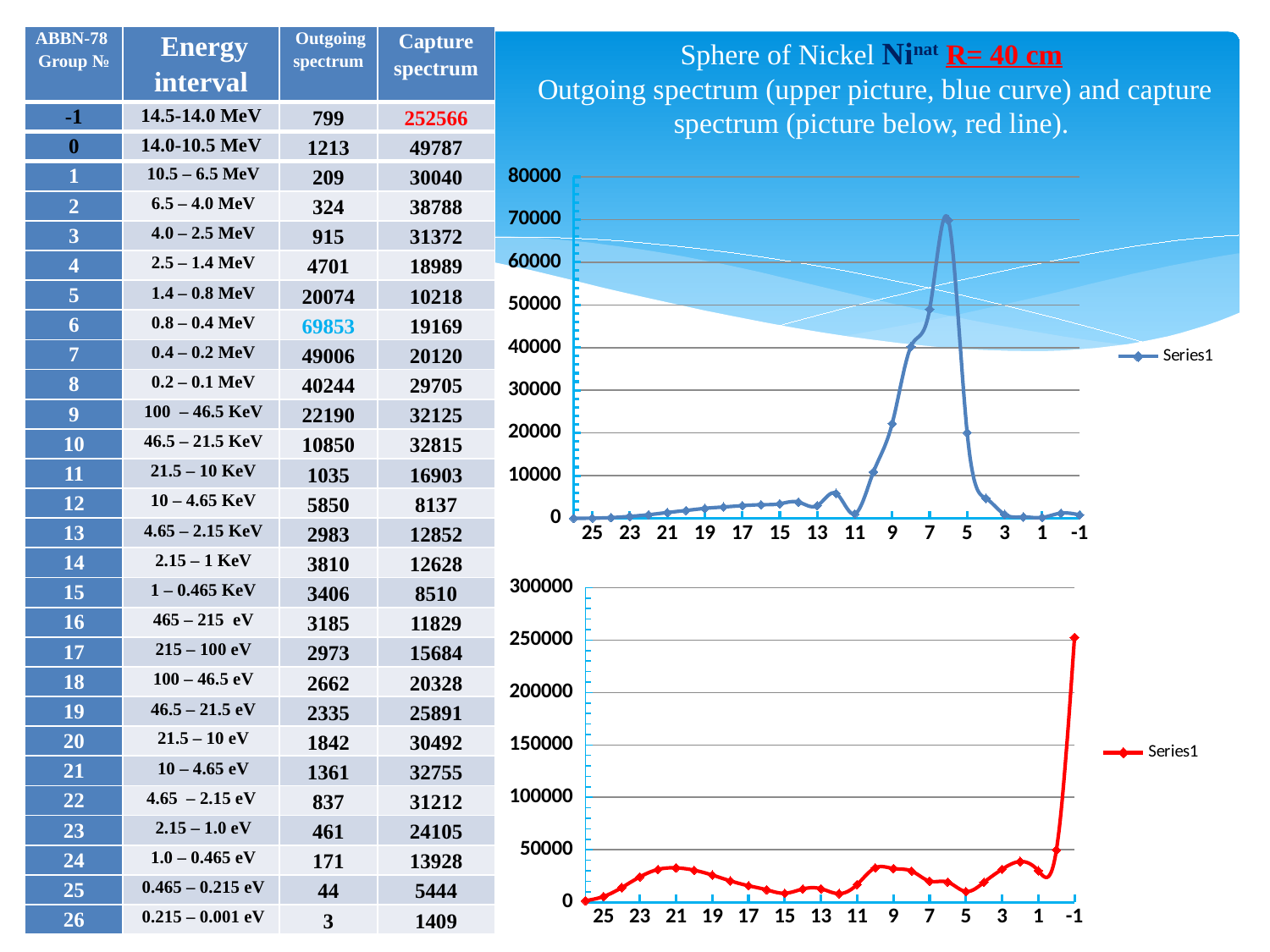
In the upper chart (blue curve), is the value at x = 9 greater or less than 30000? less In the lower chart (red line), is the value at x = 21 greater or less than 50000? less What is the name of the series shown in the legend of the upper chart? Series1 How many series does the legend of the lower chart (red line) list? 1 In the upper chart (blue curve), is the value at x = 5 greater or less than 10000? greater What kind of chart is the upper chart (blue curve)? line chart In the lower chart (red line), which is larger: the value at x = -1 or the value at x = 3? x = -1 In the lower chart (red line), at which x-axis label does the curve reach its highest value? -1 In the lower chart (red line), does the curve rise or fall between x = 3 and x = -1? rise In the upper chart (blue curve), which is larger: the value at x = 7 or the value at x = 9? x = 7